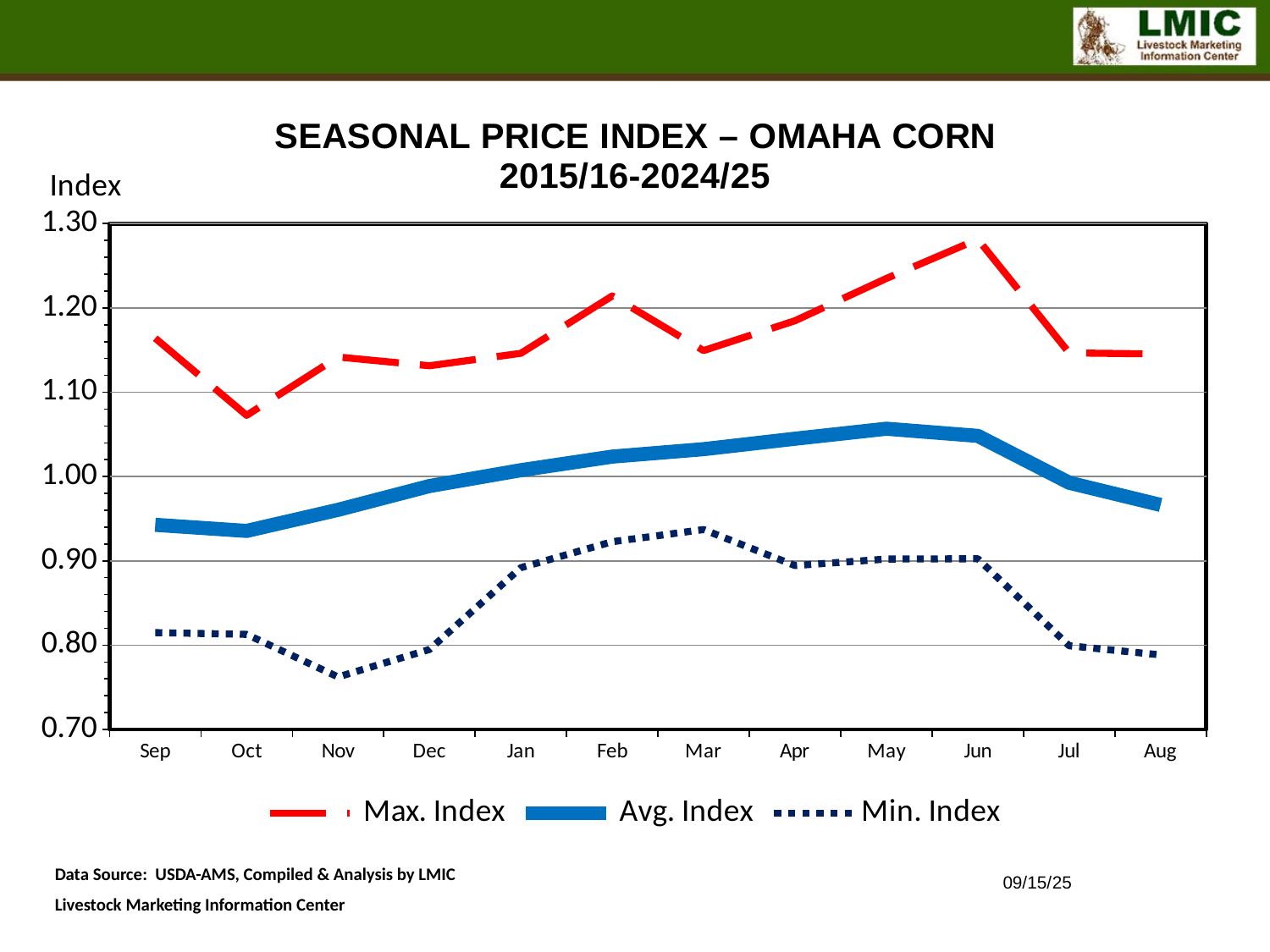
Is the Max. Index value for Jun greater or less than 1.20? greater Does the Avg. Index rise or fall from Sep to May? rise Is the Avg. Index value for Sep greater or less than 1.00? less Is the Min. Index value for Nov greater or less than 0.80? less In which month is the Min. Index at its lowest? Nov How many series does the legend list? 3 In which month does the Max. Index reach its highest value? Jun What kind of chart is shown on the slide? line chart In which month is the Max. Index at its lowest? Oct Which is larger, the Avg. Index in May or the Avg. Index in Sep? May In which month does the Avg. Index reach its highest value? May How many months are plotted along the x axis? 12